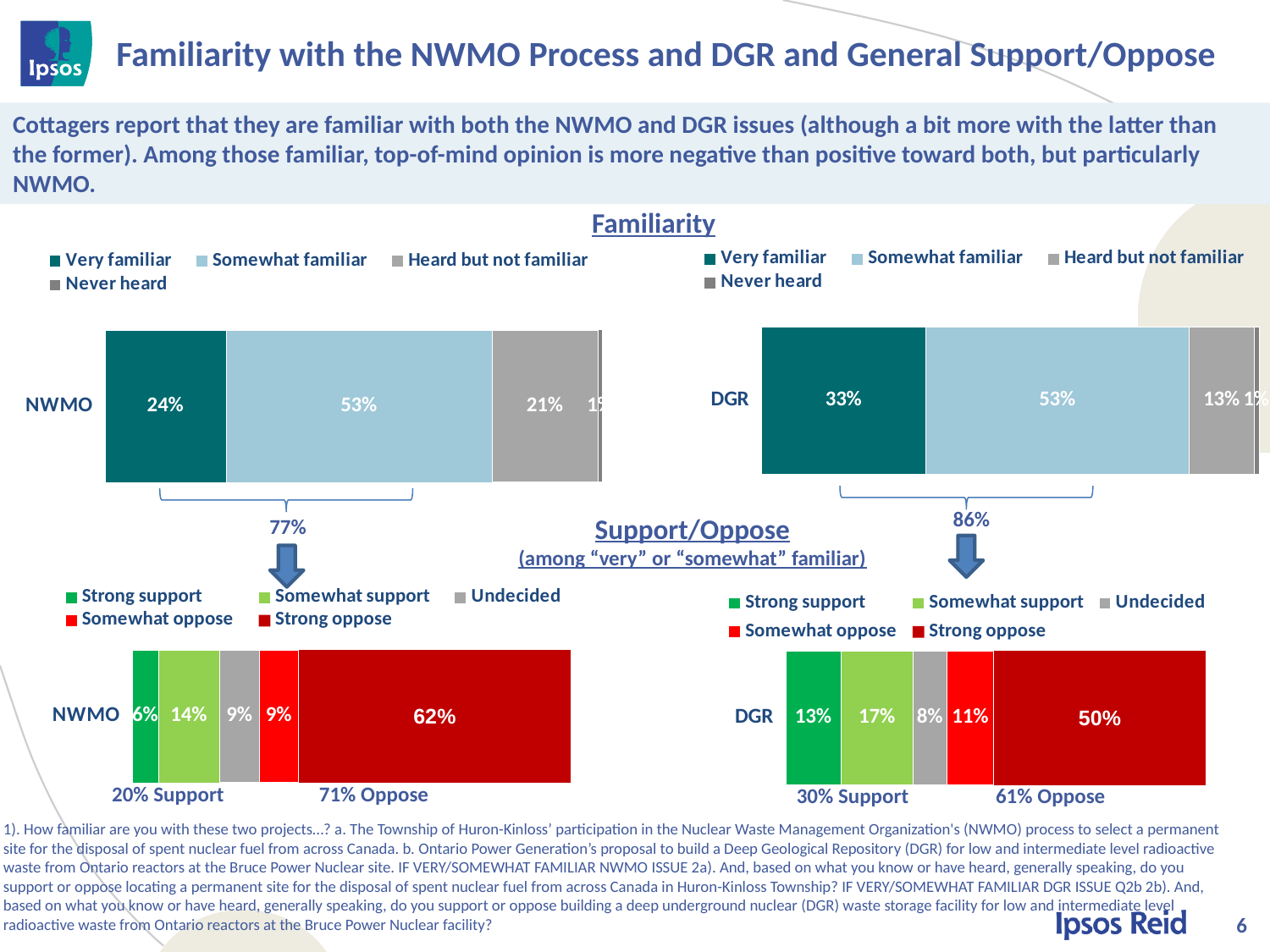
In the DGR Support/Oppose chart (bottom right), which response category has the largest share? Strong oppose In the NWMO Familiarity chart (top left), what is the combined 'Very familiar' plus 'Somewhat familiar' percentage shown under the bracket? 77% In the NWMO Support/Oppose chart (bottom left), which response category has the smallest share? Strong support In the DGR Familiarity chart (top right), what percentage are 'Very familiar'? 33% Which is larger: 'Strong oppose' for NWMO (bottom left) or 'Strong oppose' for DGR (bottom right)? NWMO (62%) In the DGR Familiarity chart (top right), what percentage are 'Heard but not familiar'? 13% What type of chart is used for the DGR Familiarity chart (top right)? Stacked bar chart In the DGR Support/Oppose chart (bottom right), what percentage 'Somewhat support'? 17% How many series does the legend of the NWMO Support/Oppose chart (bottom left) list? 5 In the NWMO Familiarity chart (top left), what percentage are 'Very familiar'? 24% In the NWMO Support/Oppose chart (bottom left), what percentage 'Strong oppose'? 62% What is the difference between the 'Very familiar' percentages for DGR (33%) and NWMO (24%) in the Familiarity charts? 9 percentage points